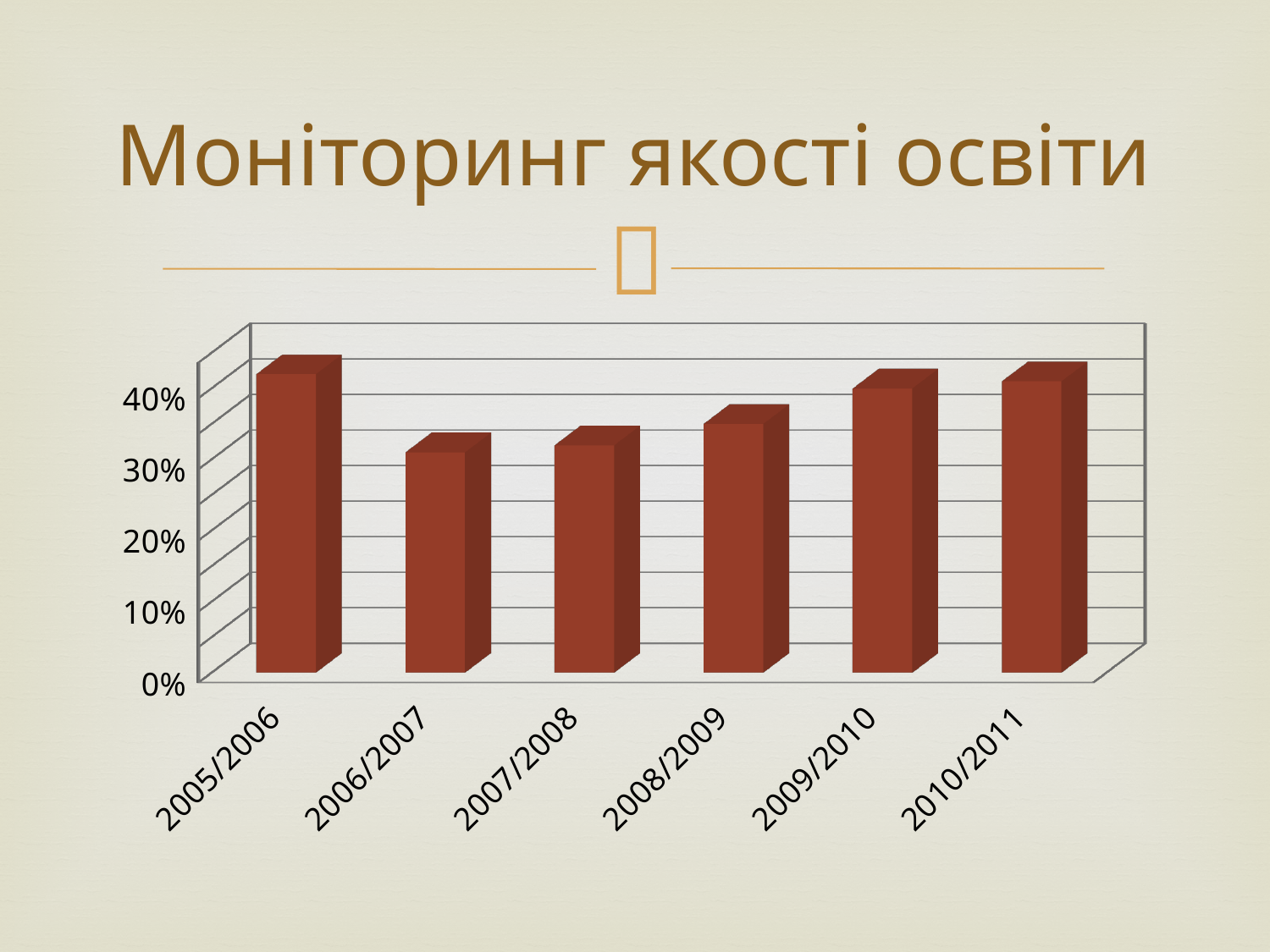
Do the values rise or fall from 2006/2007 to 2010/2011? rise Which is larger, the value for 2005/2006 or the value for 2006/2007? 2005/2006 Is the value for 2008/2009 greater or less than 40%? less Is the value for 2010/2011 greater or less than 30%? greater How many school years (categories) are shown on the x axis of the chart? 6 Is the value for 2009/2010 greater or less than 30%? greater What is the first category label on the x axis of the chart? 2005/2006 Which is larger, the value for 2009/2010 or the value for 2008/2009? 2009/2010 What is the title of the slide containing the chart? Моніторинг якості освіти What kind of chart is shown on the slide? bar chart